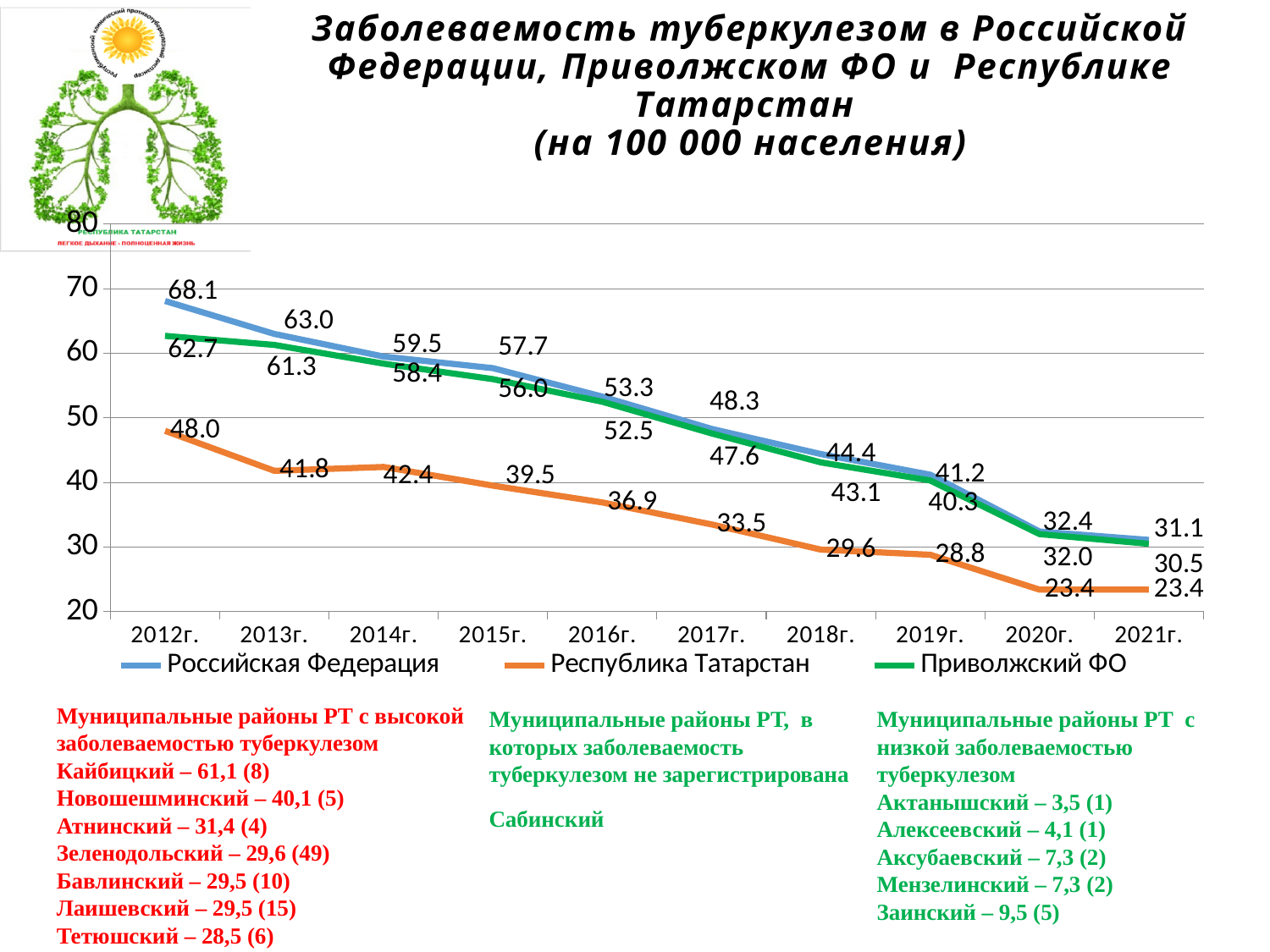
How many series does the legend list? 3 What type of chart is shown on the slide? line chart What is the value for Приволжский ФО in 2019г.? 40.3 What is the value for Российская Федерация in 2012г.? 68.1 In which year is the value for Российская Федерация lowest? 2021г. In which year is the value for Республика Татарстан highest? 2012г. Which series is drawn in orange? Республика Татарстан Which is larger in 2016г.: the value for Российская Федерация or for Приволжский ФО? Российская Федерация What is the value for Республика Татарстан in 2017г.? 33.5 How many years are shown on the x axis? 10 Do the values for Республика Татарстан generally rise or fall from 2012г. to 2021г.? fall What is the difference between the Российская Федерация value and the Республика Татарстан value in 2021г.? 7.7